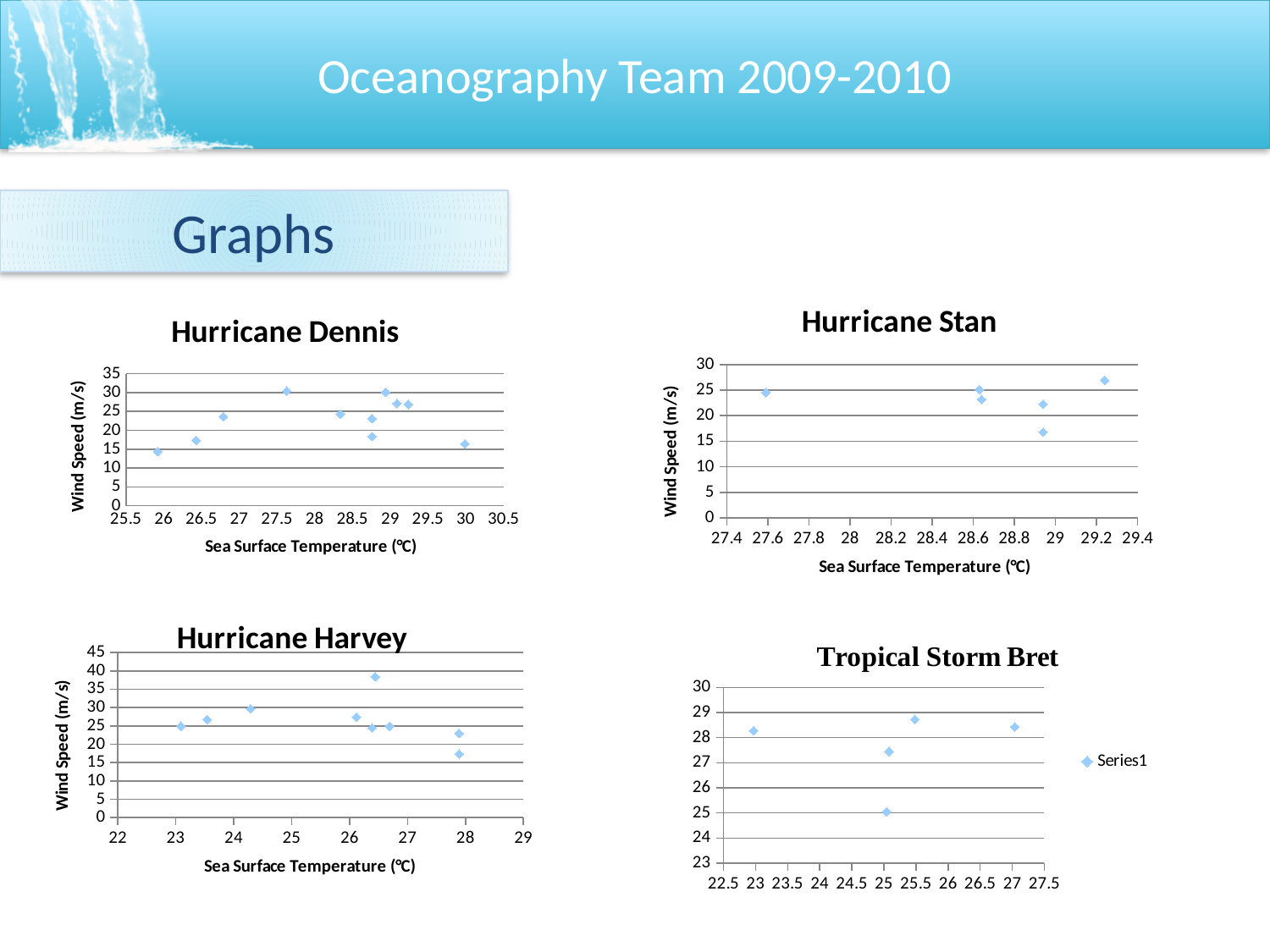
In the Tropical Storm Bret chart, is the value for the point near 23 on the x axis greater or less than 28? greater How many series does the legend of the Tropical Storm Bret chart list? 1 What kind of chart is the Hurricane Dennis chart? scatter chart How many data points are plotted in the Hurricane Stan chart? 6 In the Hurricane Stan chart, is the wind speed for the point near a sea surface temperature of 27.6 greater or less than 20? greater In the Hurricane Harvey chart, is the highest wind speed plotted greater or less than 35? greater How many data points are plotted in the Tropical Storm Bret chart? 5 What is the legend entry shown on the Tropical Storm Bret chart? Series1 How many data points are plotted in the Hurricane Harvey chart? 9 What is the y-axis title of the Hurricane Stan chart? Wind Speed (m/s)